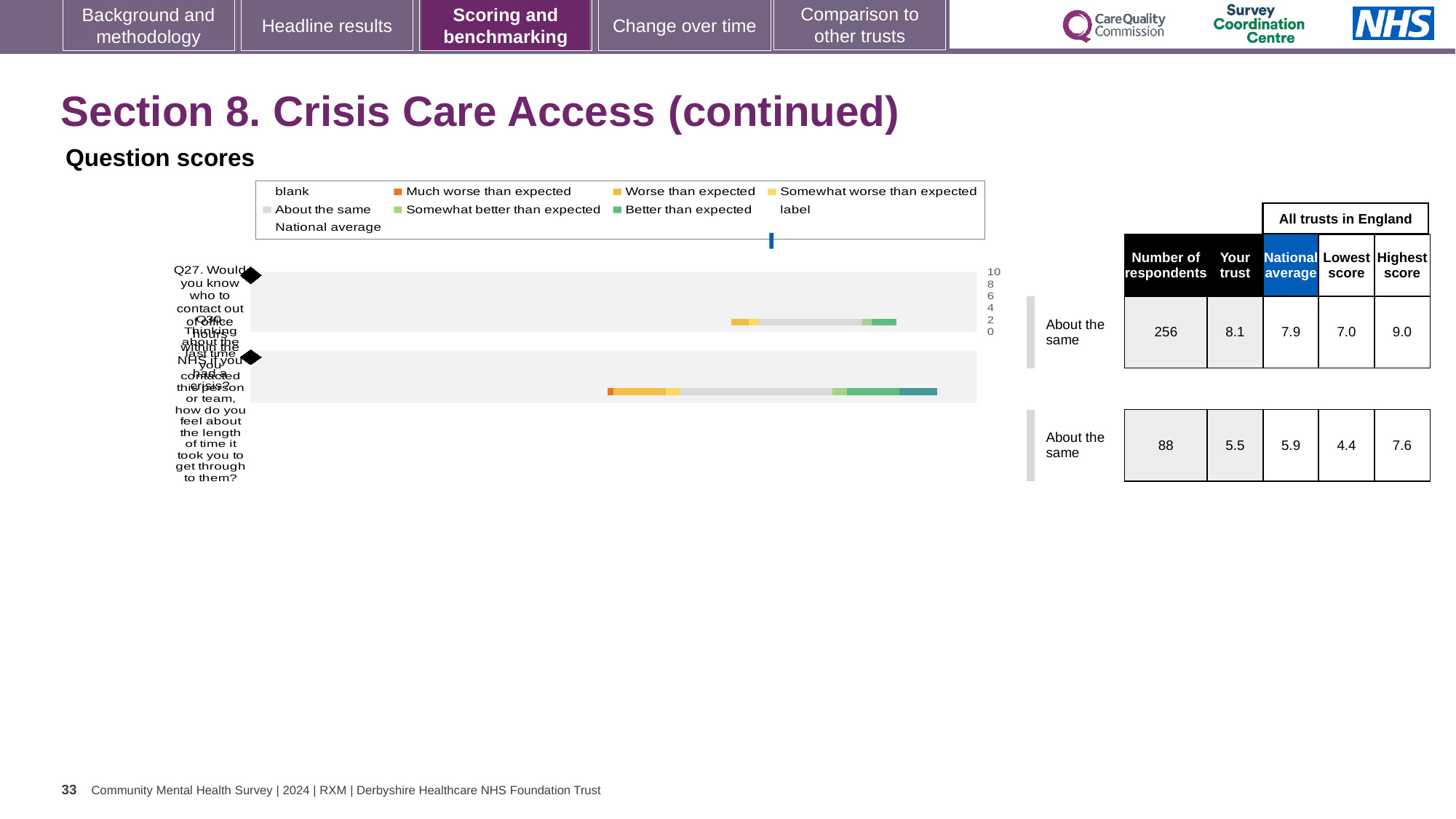
What is the 'Your trust' score for Q27 in the table beside the chart? 8.1 What kind of chart is shown under 'Question scores'? Bar chart What is the national average score for Q30? 5.9 For Q27, which is larger: the 'Your trust' score or the national average? Your trust Which question has the higher 'Your trust' score, Q27 or Q30? Q27 Is the 'Your trust' score for Q30 greater or less than 6? less What benchmark category is shown next to the Q30 bar? About the same How many respondents answered Q30? 88 What does the blue vertical marker in the chart legend represent? National average In the chart legend, which colour represents 'Much worse than expected'? Orange What is the difference between the highest score and the lowest score for Q27? 2.0 How many questions (bars) are plotted in the Question scores chart? 2